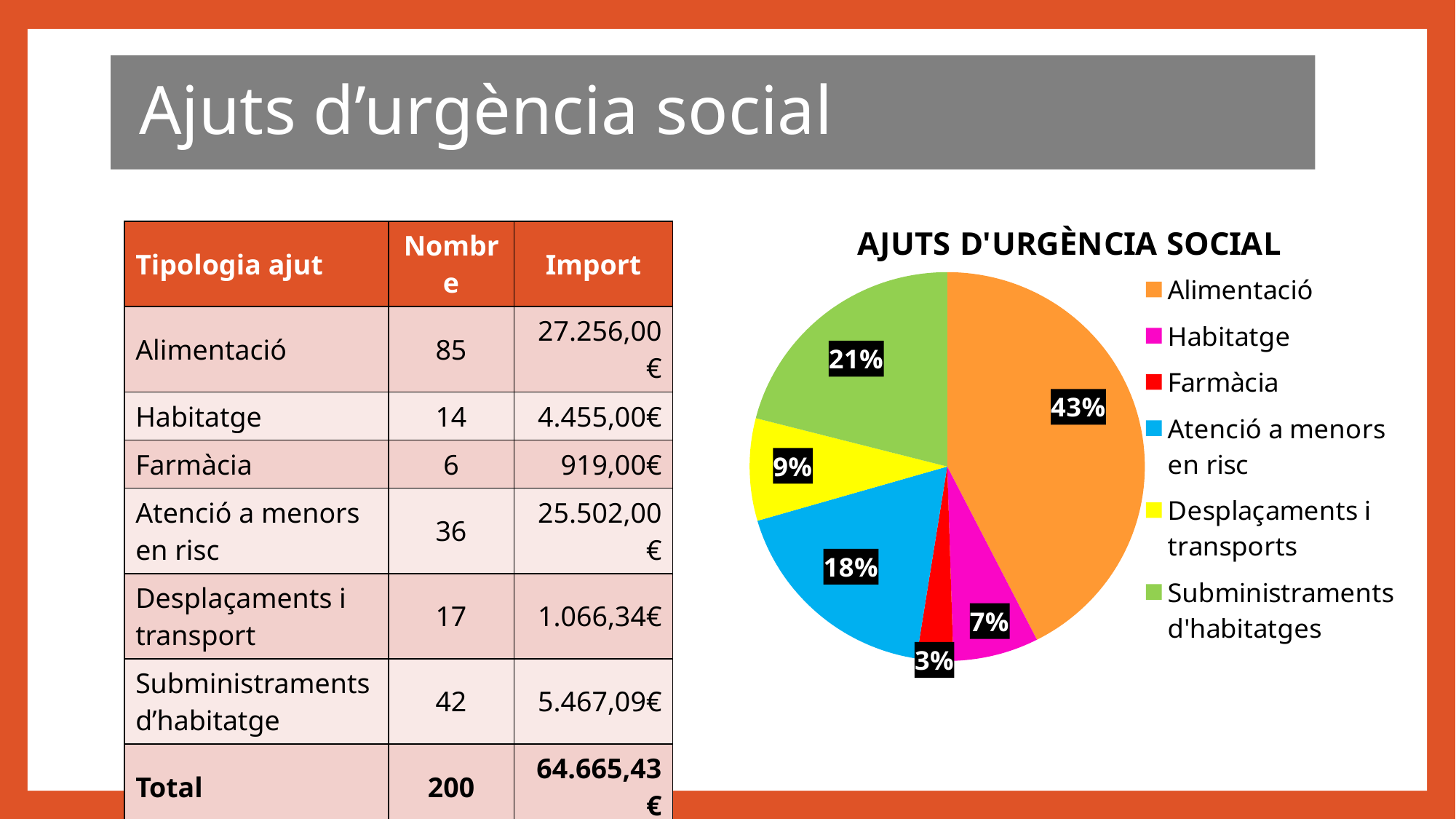
What is the title of the pie chart? AJUTS D'URGÈNCIA SOCIAL What percentage is shown for Farmàcia in the pie chart? 3% What percentage is shown for Subministraments d'habitatges in the pie chart? 21% Which category has the largest slice in the pie chart? Alimentació What is the difference in percentage points between Subministraments d'habitatges and Desplaçaments i transports in the pie chart? 12 What percentage is shown for Atenció a menors en risc in the pie chart? 18% What share of the pie chart does Alimentació represent? 43% How many entries does the legend of the pie chart list? 6 What kind of chart is shown on the slide? Pie chart How many slices does the pie chart have? 6 Which category has the smallest slice in the pie chart? Farmàcia Which slice is larger in the pie chart, Habitatge or Desplaçaments i transports? Desplaçaments i transports